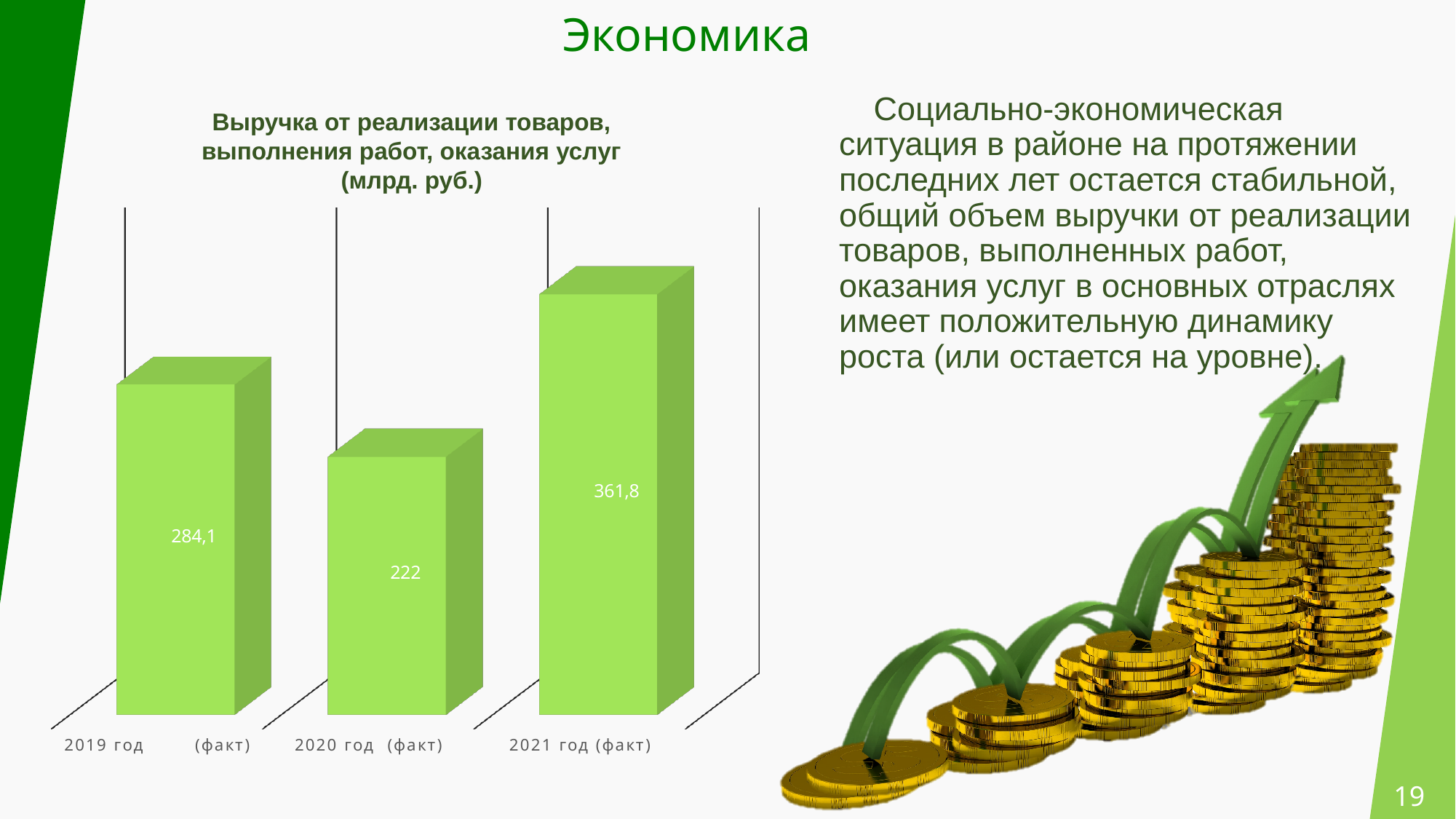
What is the difference between the values for 2019 год (факт) and 2020 год (факт)? 62,1 How many bars are shown in the chart? 3 What is the value for 2020 год (факт)? 222 Which year has the lowest value? 2020 год (факт) What is the value for 2019 год (факт)? 284,1 What kind of chart is shown on the slide? Bar chart What is the difference between the values for 2021 год (факт) and 2019 год (факт)? 77,7 Which is larger, the value for 2019 год (факт) or the value for 2020 год (факт)? 2019 год (факт) Which year has the highest value? 2021 год (факт) Does the value rise or fall from 2020 год (факт) to 2021 год (факт)? Rise What is the value for 2021 год (факт)? 361,8 What unit is given in the chart title? млрд. руб.